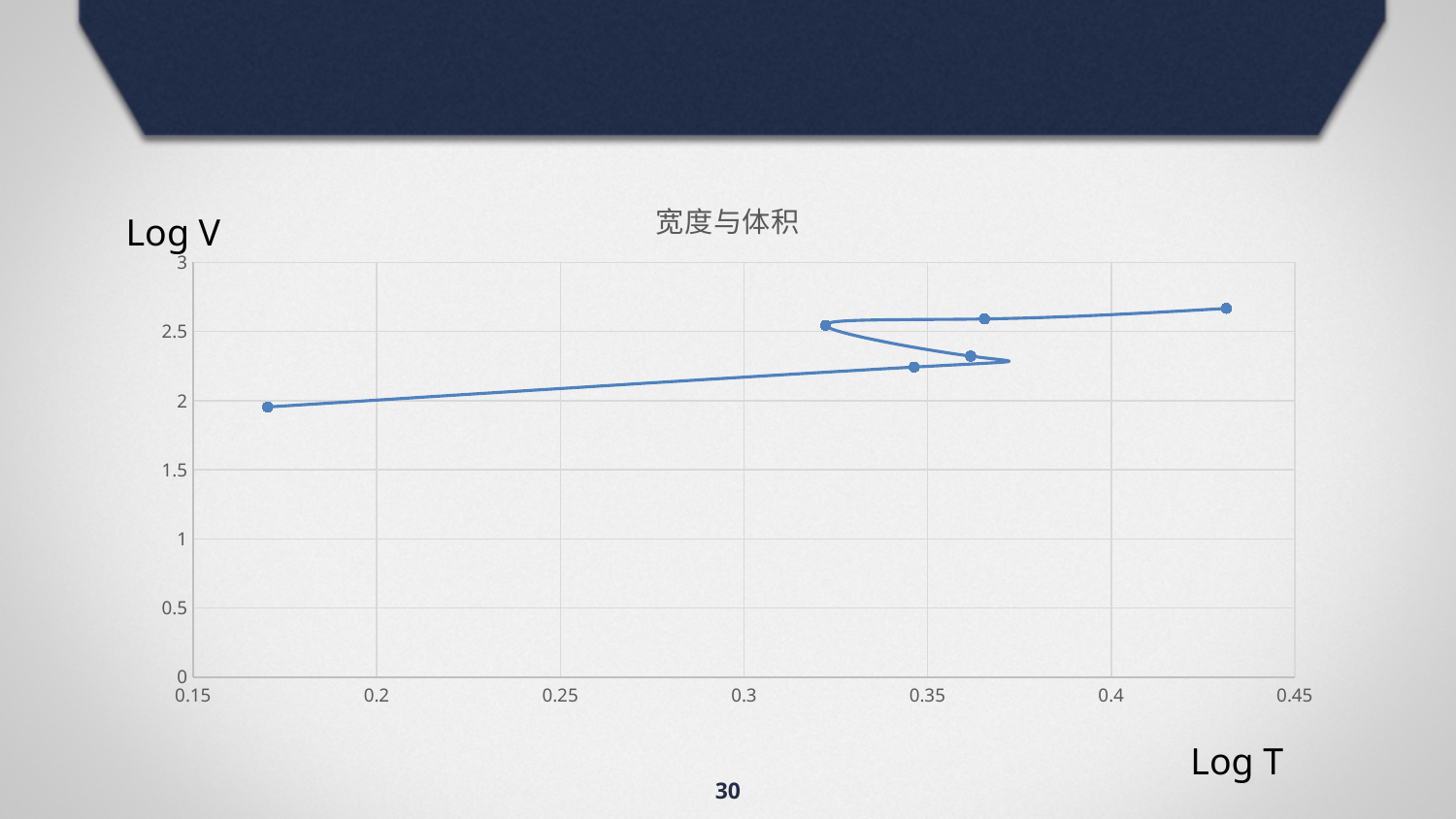
What kind of chart is shown on the slide? Scatter chart with a smoothed line Is the Log V value of the data point near Log T 0.345 greater or less than 2.5? less Is the Log V value of the leftmost data point (near Log T 0.17) greater or less than 1.5? greater Is the Log T value of the rightmost data point greater or less than 0.4? greater What is the title of the chart? 宽度与体积 What label is shown on the vertical axis of the chart? Log V How many data points are plotted on the chart? 6 Which data point has the highest Log V value on the chart? The rightmost point (near Log T 0.43) Which data point has the lowest Log V value: the leftmost point (near Log T 0.17) or the rightmost point (near Log T 0.43)? The leftmost point (near Log T 0.17)